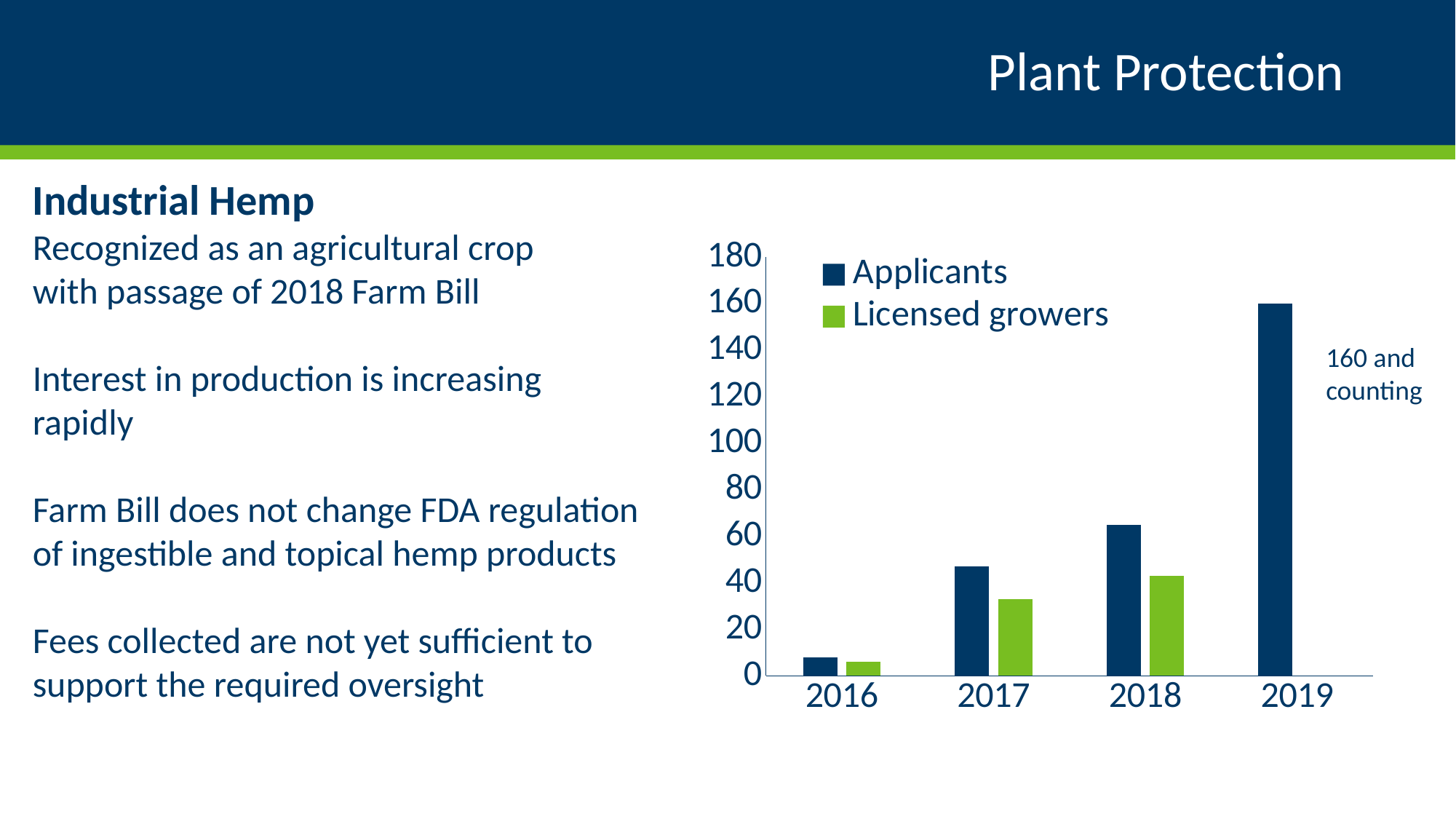
What kind of chart is shown on the slide? bar chart Do the Applicants values rise or fall from 2016 to 2019? rise Is the value for Applicants in 2016 greater or less than 20? less How many series does the chart legend list? 2 Is the value for Applicants in 2017 greater or less than 40? greater How many years are shown on the x axis of the chart? 4 Which year has the lowest number of Applicants? 2016 Is the value for Licensed growers in 2017 greater or less than 40? less According to the annotation on the chart, how many Applicants were there in 2019? 160 In 2018, which is larger: Applicants or Licensed growers? Applicants Which year has the highest number of Licensed growers? 2018 Which year has the highest number of Applicants? 2019